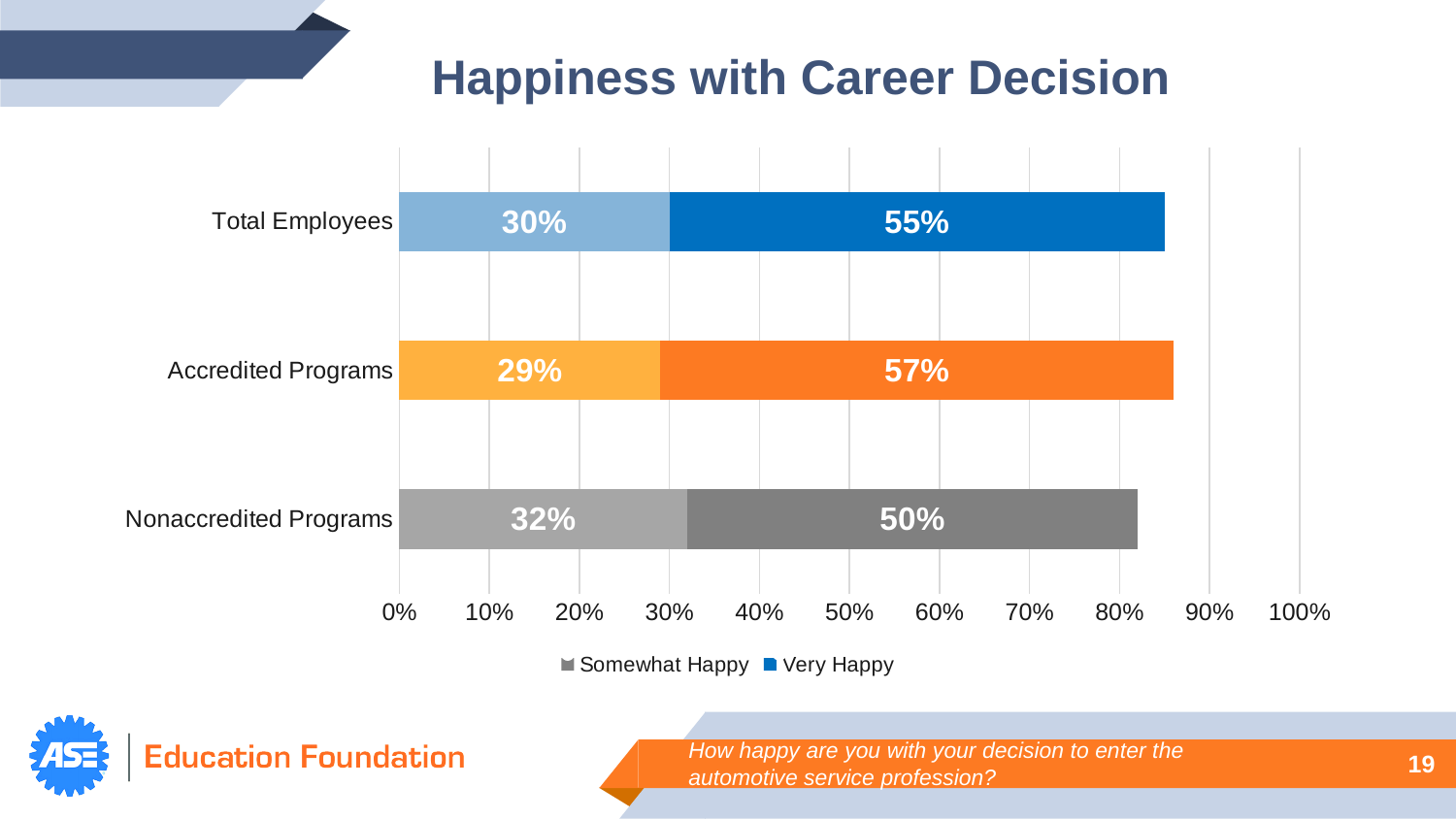
What is the difference between the Very Happy percentages for Accredited Programs and Nonaccredited Programs? 7% What is the combined Somewhat Happy and Very Happy total for Nonaccredited Programs? 82% How many series does the legend list? 2 Which category has the lowest Somewhat Happy percentage? Accredited Programs What percentage of Nonaccredited Programs respondents are Very Happy? 50% What percentage of Accredited Programs respondents are Somewhat Happy? 29% Which category has the highest Very Happy percentage? Accredited Programs How many categories are shown on the chart? 3 What type of chart is shown on the slide? Stacked bar chart What is the combined Somewhat Happy and Very Happy total for Total Employees? 85% What percentage of Total Employees are Very Happy with their career decision? 55% Which is larger: the Somewhat Happy percentage for Nonaccredited Programs or for Total Employees? Nonaccredited Programs